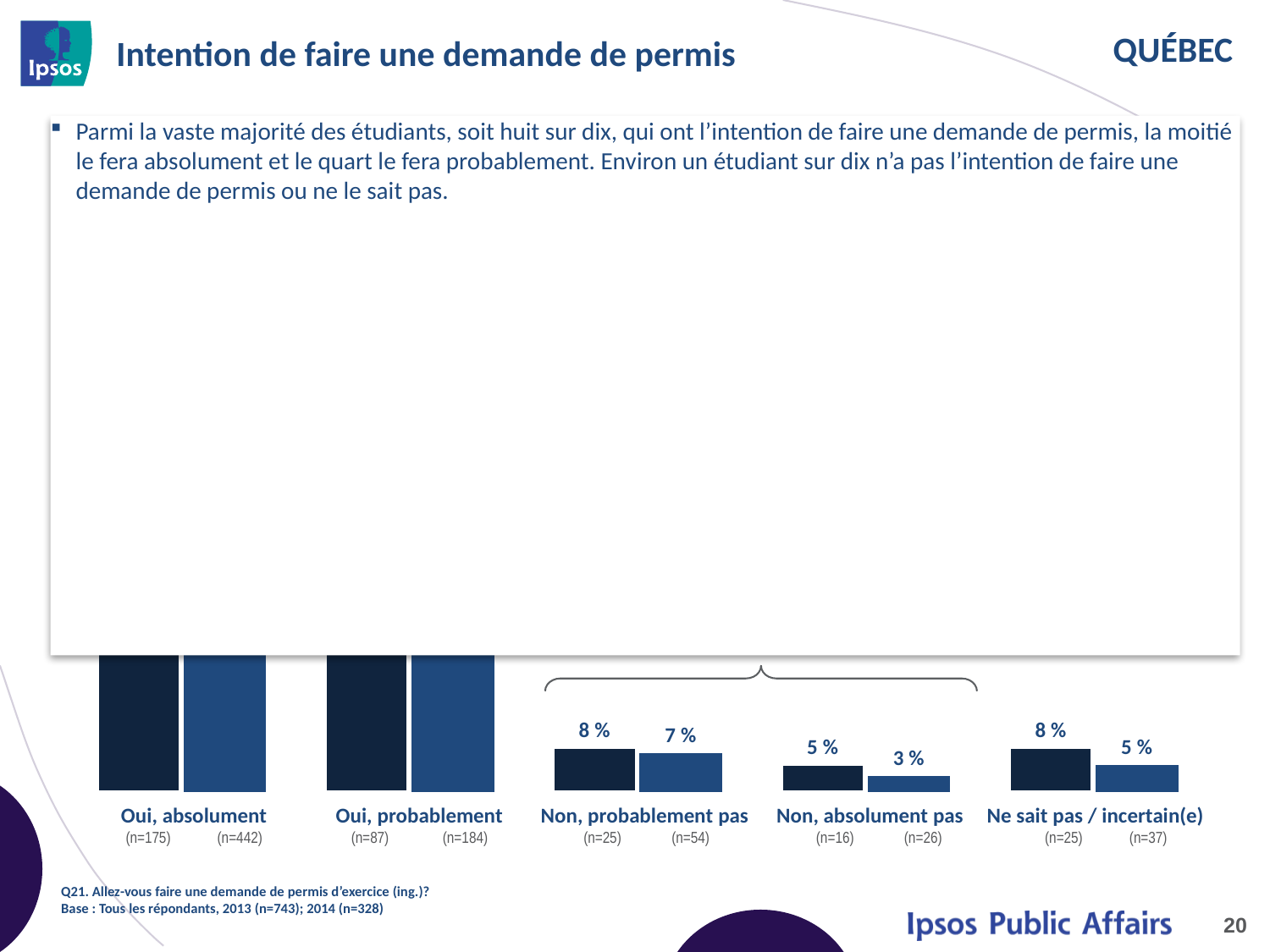
What is the value of the dark navy bar for 'Ne sait pas / incertain(e)'? 8 % Which category has the lowest value in the chart? Non, absolument pas What is the value of the lighter blue bar for 'Non, probablement pas'? 7 % What kind of chart is shown on the slide? bar chart What is the value of the dark navy bar for 'Non, absolument pas'? 5 % What is the value of the lighter blue bar for 'Non, absolument pas'? 3 % How many response categories are shown along the x axis of the chart? 5 What is the difference between the dark navy and lighter blue bars for 'Non, absolument pas'? 2 percentage points For 'Ne sait pas / incertain(e)', which bar is larger, the dark navy one or the lighter blue one? the dark navy one (8 %) What sample sizes are printed under the 'Oui, absolument' category? (n=175) and (n=442) What is the value of the dark navy bar for 'Non, probablement pas'? 8 % What is the value of the lighter blue bar for 'Ne sait pas / incertain(e)'? 5 %